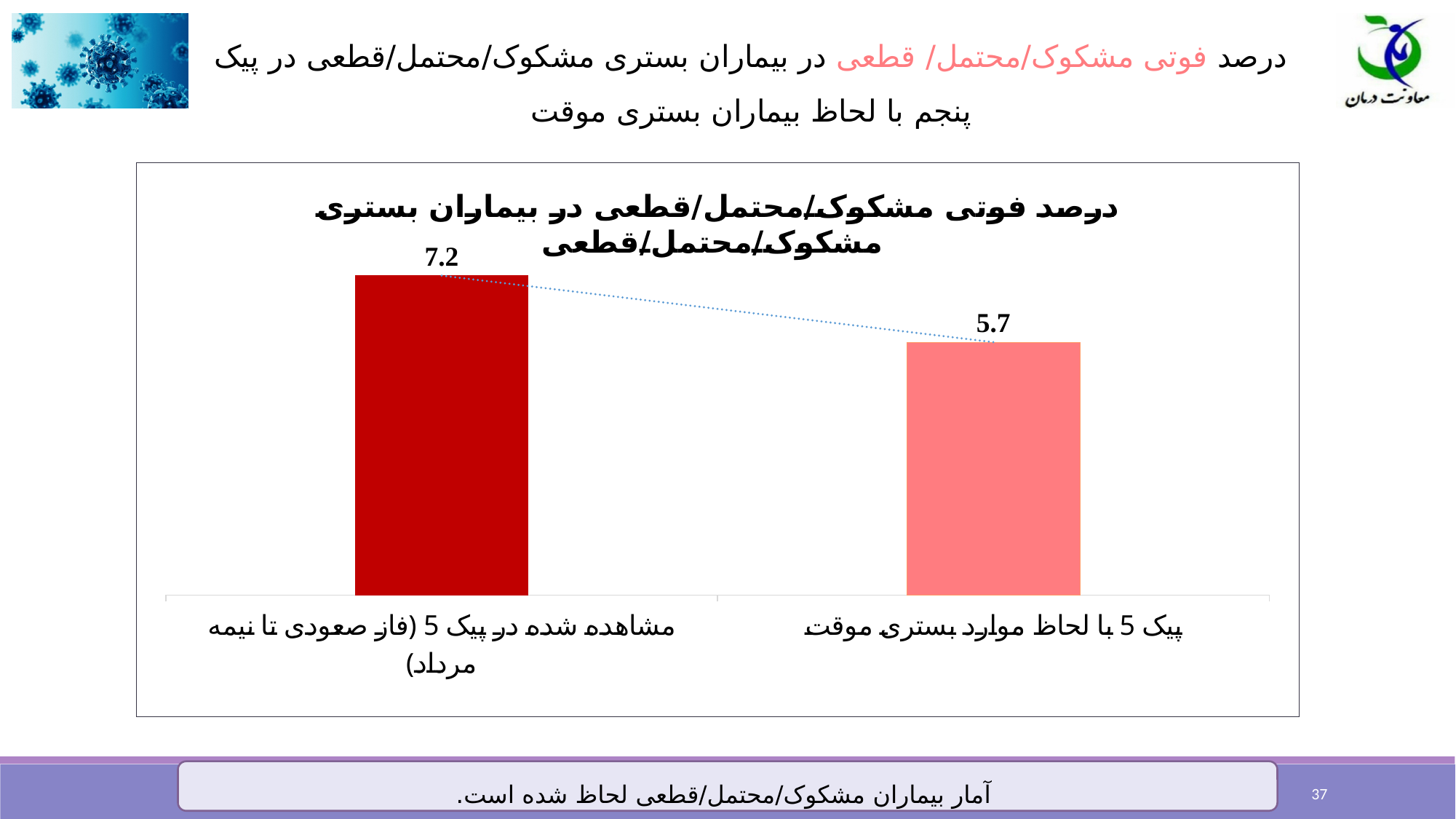
What is the value for the category "پیک 5 با لحاظ موارد بستری موقت"? 5.7 Do the values rise or fall from the left bar to the right bar? Fall What is the difference between the value for "مشاهده شده در پیک 5 (فاز صعودی تا نیمه مرداد)" and the value for "پیک 5 با لحاظ موارد بستری موقت"? 1.5 Which category has the highest value? مشاهده شده در پیک 5 (فاز صعودی تا نیمه مرداد) Which category has the lowest value? پیک 5 با لحاظ موارد بستری موقت Which is larger: the value for "مشاهده شده در پیک 5 (فاز صعودی تا نیمه مرداد)" or the value for "پیک 5 با لحاظ موارد بستری موقت"? مشاهده شده در پیک 5 (فاز صعودی تا نیمه مرداد) What is the value for the category "مشاهده شده در پیک 5 (فاز صعودی تا نیمه مرداد)"? 7.2 What kind of chart is shown on the slide? Bar chart What colour is the bar for "مشاهده شده در پیک 5 (فاز صعودی تا نیمه مرداد)"? Dark red What is the title of the chart? درصد فوتی مشکوک/محتمل/قطعی در بیماران بستری مشکوک/محتمل/قطعی How many bars are shown in the chart? 2